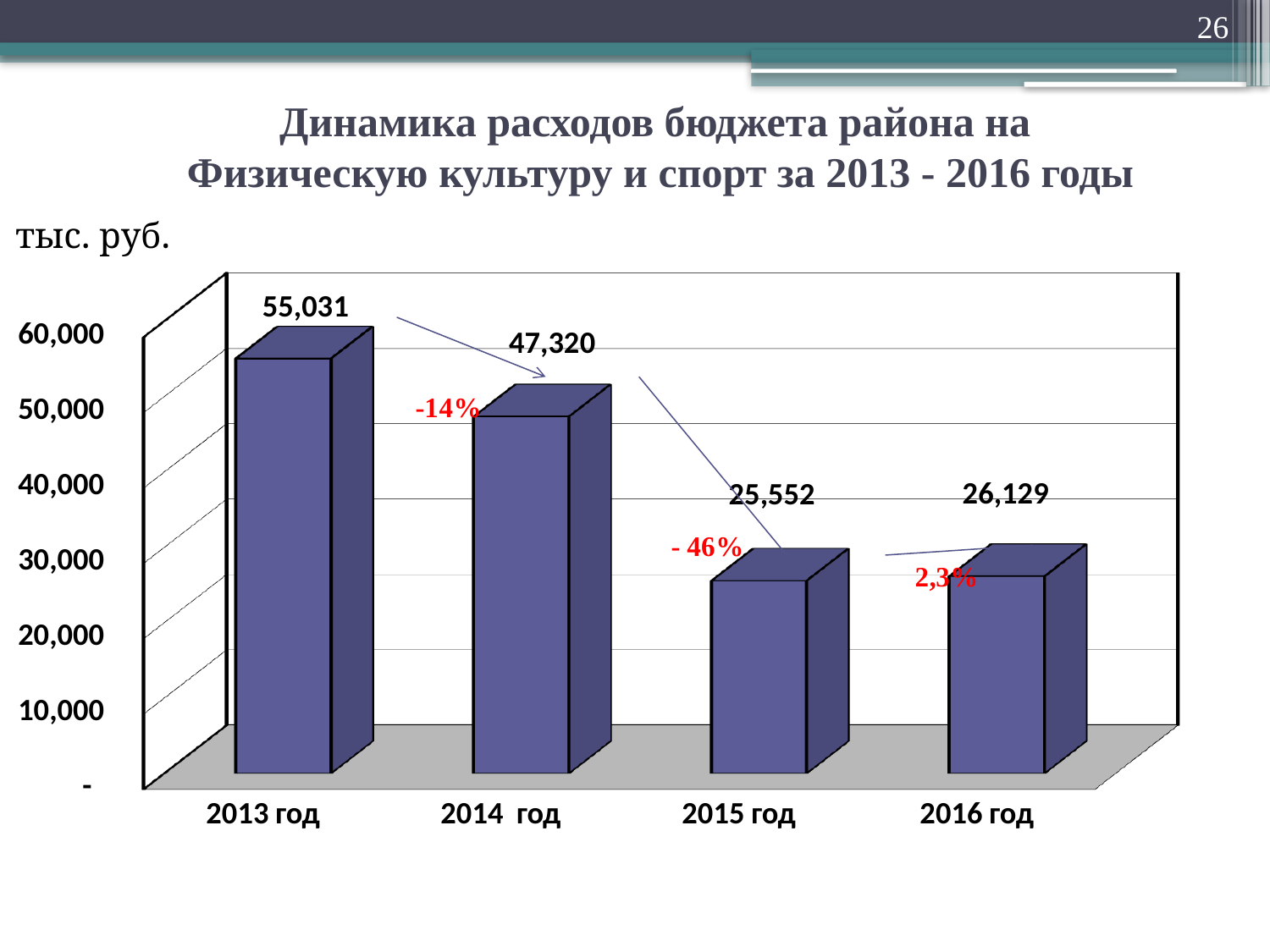
What kind of chart is shown on the slide? bar chart How many years are shown on the chart? 4 What is the value for 2015 год? 25,552 What is the difference between the values for 2016 год and 2015 год? 577 What is the value for 2014 год? 47,320 What is the value for 2016 год? 26,129 What is the difference between the values for 2013 год and 2014 год? 7,711 What is the value for 2013 год? 55,031 Which year has the lowest value? 2015 год What percentage change is labelled between 2014 год and 2015 год? - 46% Which year has the highest value? 2013 год Which is larger, the value for 2015 год or the value for 2016 год? 2016 год